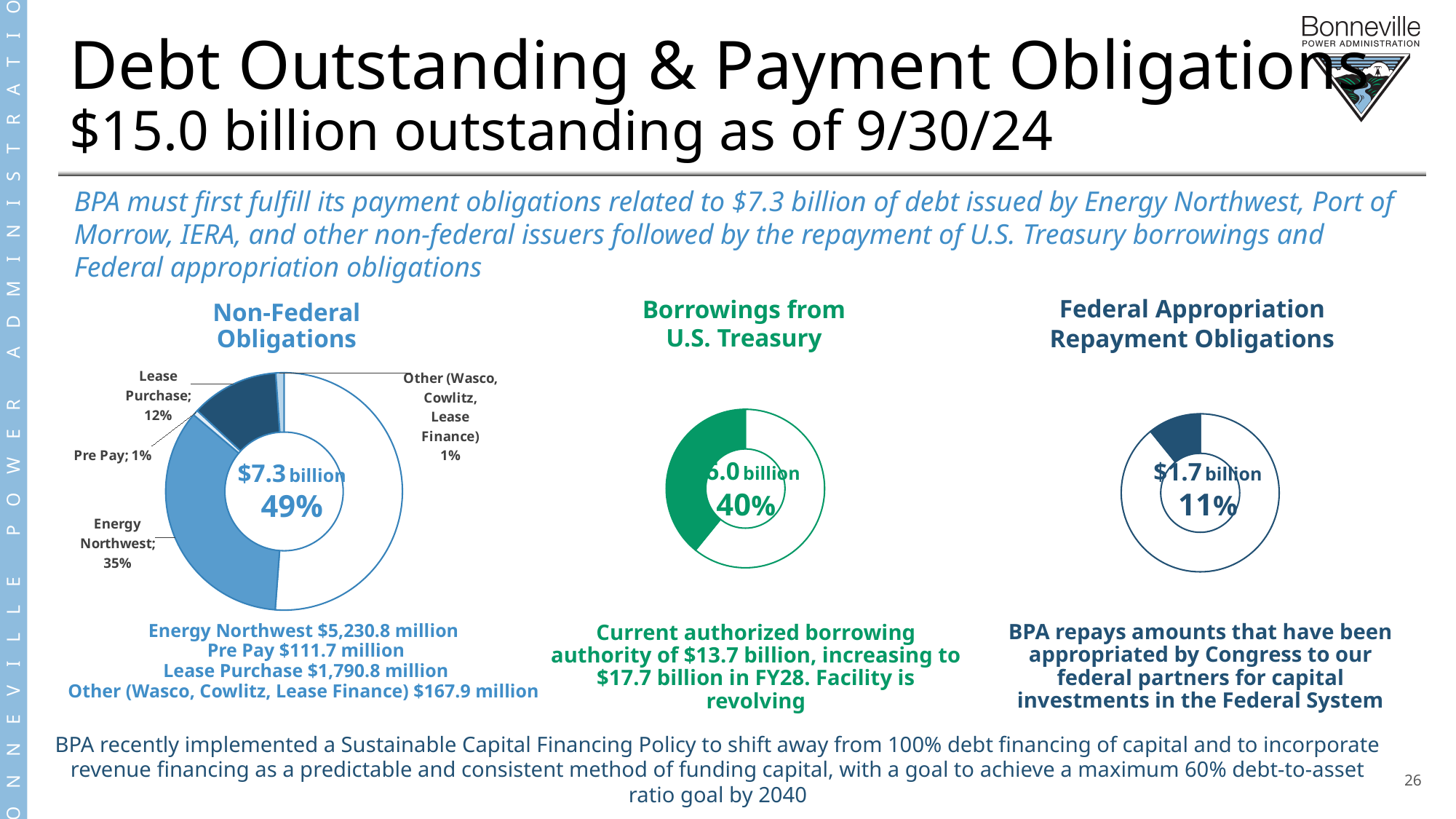
What is the title of the middle chart on the slide? Borrowings from U.S. Treasury In the Non-Federal Obligations chart, which labeled slice has the largest share? Energy Northwest What percentage is shown in the center of the Federal Appropriation Repayment Obligations chart? 11% What percentage is shown in the center of the Borrowings from U.S. Treasury chart? 40% In the Non-Federal Obligations chart, which is larger, Lease Purchase or Pre Pay? Lease Purchase What total value is shown in the center of the Non-Federal Obligations chart? $7.3 billion How many labeled slices does the Non-Federal Obligations chart have? 4 What kind of chart is the Non-Federal Obligations chart? doughnut chart What value is shown in the center of the Federal Appropriation Repayment Obligations chart? $1.7 billion In the Non-Federal Obligations chart, what percentage is shown for Energy Northwest? 35% In the Non-Federal Obligations chart, what is the difference in percentage points between Energy Northwest and Lease Purchase? 23 percentage points In the Non-Federal Obligations chart, what percentage is shown for Lease Purchase? 12%